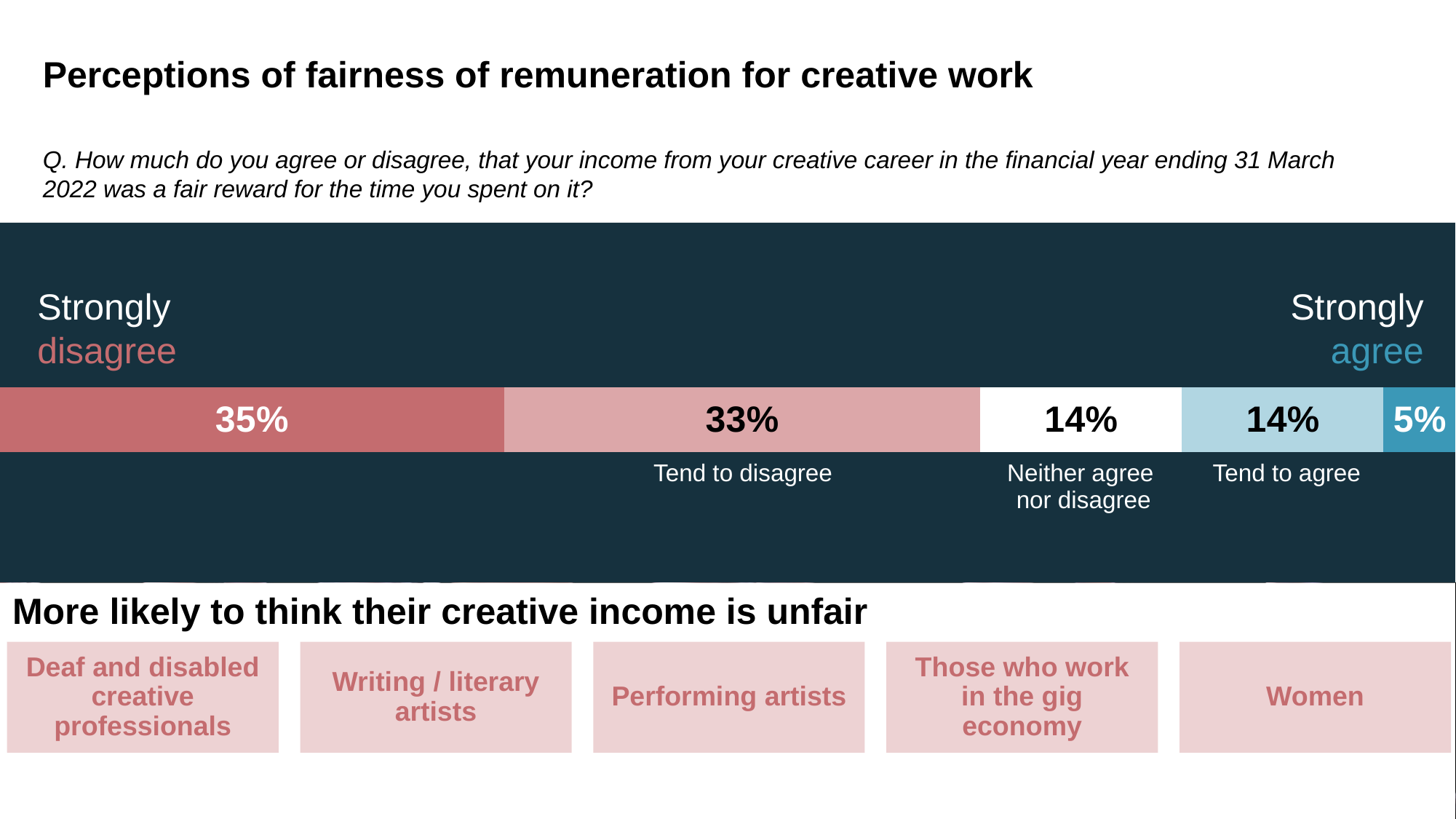
Which is larger, the share for 'Tend to agree' or the share for 'Strongly agree'? Tend to agree What percentage of respondents strongly agree? 5% What percentage of respondents strongly disagree that their creative income was a fair reward? 35% What is the difference in percentage points between 'Strongly disagree' and 'Tend to disagree'? 2 How many response categories are shown in the bar? 5 What percentage of respondents tend to disagree? 33% Which response category has the largest share? Strongly disagree What is the combined percentage of respondents who strongly disagree or tend to disagree? 68% Which response category has the smallest share? Strongly agree What kind of chart is shown on the slide? Stacked bar chart What percentage of respondents neither agree nor disagree? 14% What is the title of the chart on the slide? Perceptions of fairness of remuneration for creative work